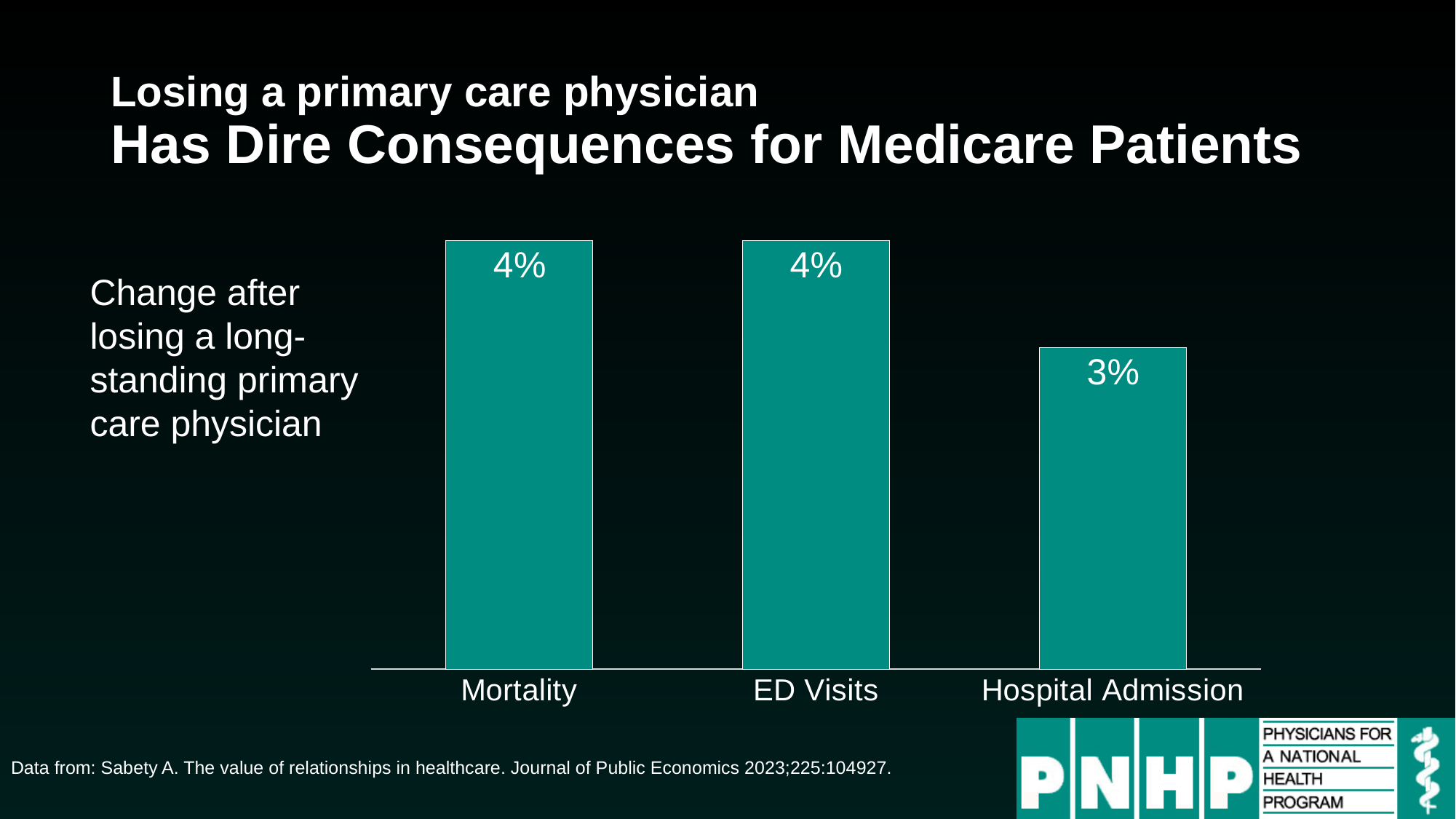
Do the values rise or fall from Mortality to Hospital Admission along the x axis? Fall What is the value for Hospital Admission? 3% How many categories are shown on the x axis? 3 Which category has the lowest value? Hospital Admission Which is larger, the value for ED Visits or the value for Hospital Admission? ED Visits What colour are the bars in the chart? Teal What kind of chart is shown on the slide? Bar chart What is the value for Mortality? 4% What is the value for ED Visits? 4% What does the text to the left of the chart say the bars represent? Change after losing a long-standing primary care physician What is the difference between the values for Mortality and Hospital Admission? 1%